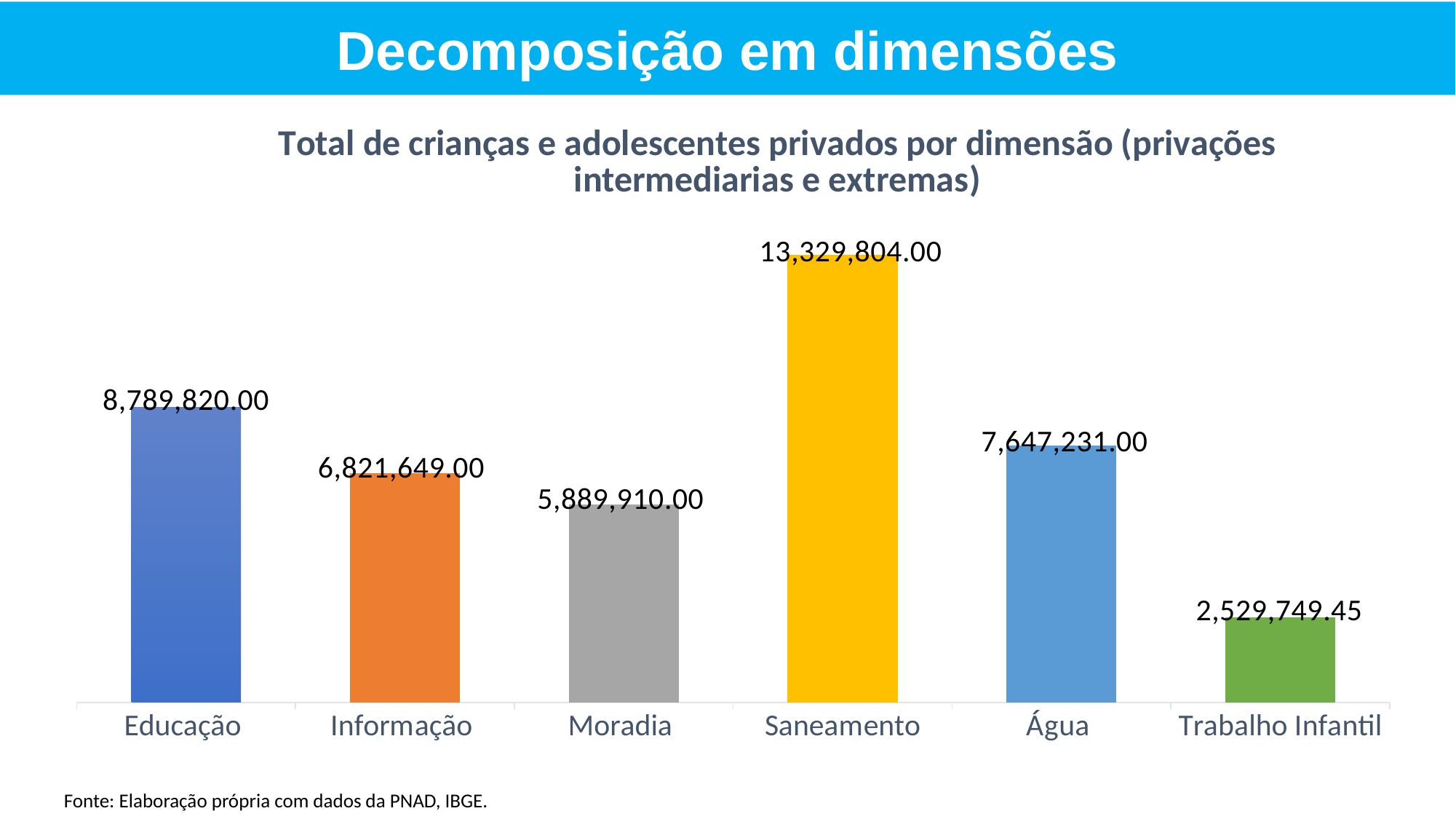
Which category has the highest value? Saneamento Which category has the lowest value? Trabalho Infantil What is the difference between the values for Saneamento and Educação? 4,539,984.00 What is the value for Trabalho Infantil? 2,529,749.45 What is the value for Moradia? 5,889,910.00 What is the difference between the values for Informação and Moradia? 931,739.00 What kind of chart is shown on the slide? Bar chart What is the value for Saneamento? 13,329,804.00 What is the value for Água? 7,647,231.00 What is the title of the chart? Total de crianças e adolescentes privados por dimensão (privações intermediarias e extremas) How many categories are shown in the chart? 6 Which is larger, the value for Educação or the value for Água? Educação